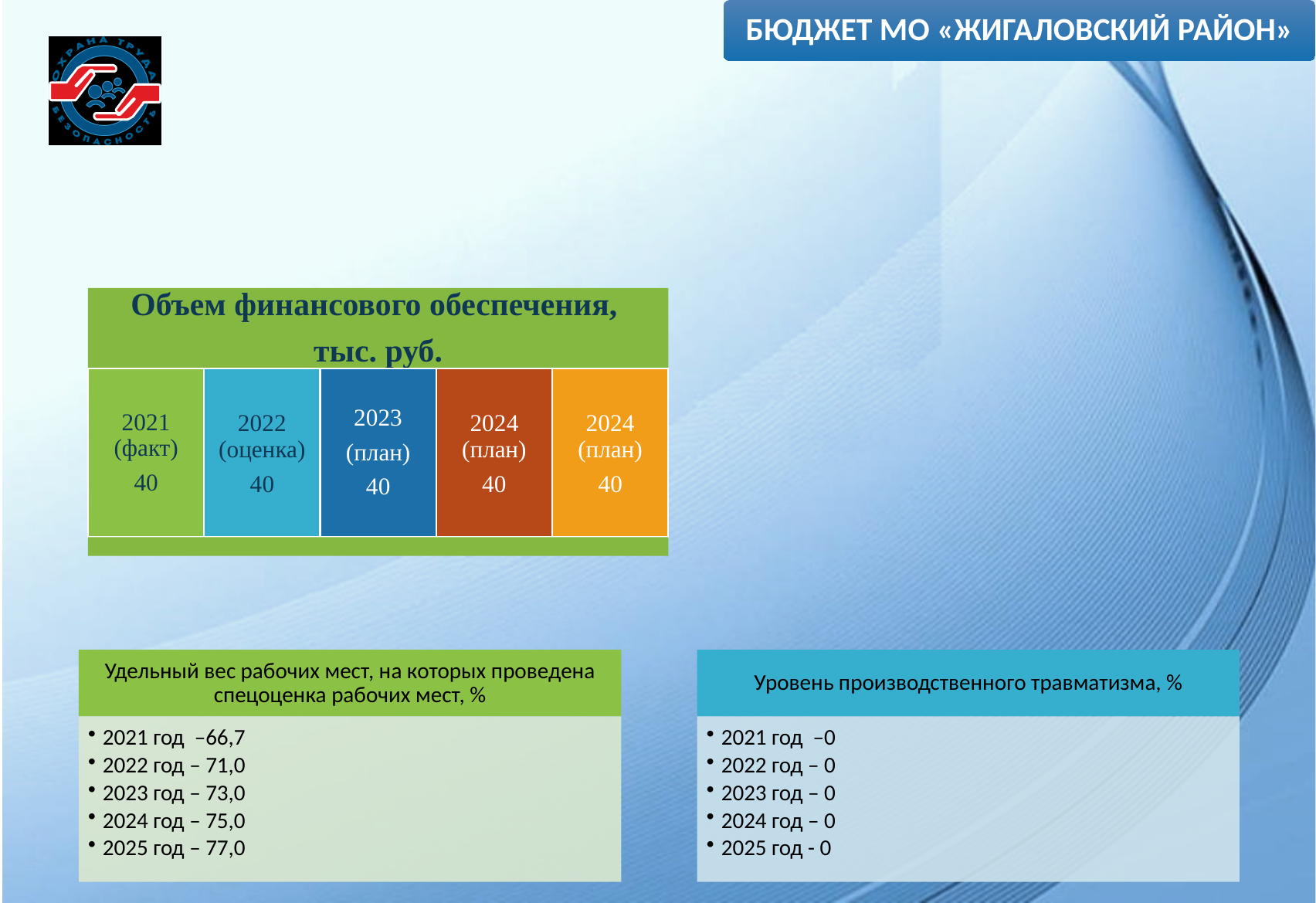
What is the value for 2022 (оценка) in the chart "Объем финансового обеспечения, тыс. руб."? 40 What is the title of the chart on the slide? Объем финансового обеспечения, тыс. руб. What is the value for 2023 (план) in the chart "Объем финансового обеспечения, тыс. руб."? 40 Do the values in the chart "Объем финансового обеспечения, тыс. руб." rise, fall, or stay the same from 2021 to 2024? stay the same In the chart "Объем финансового обеспечения, тыс. руб.", is the value for 2022 (оценка) larger than, smaller than, or equal to the value for 2023 (план)? equal What unit is stated in the title of the chart "Объем финансового обеспечения"? тыс. руб. How many categories (blocks) are shown in the chart "Объем финансового обеспечения, тыс. руб."? 5 Which category label in the chart "Объем финансового обеспечения, тыс. руб." is marked as "факт"? 2021 What is the value for 2021 (факт) in the chart "Объем финансового обеспечения, тыс. руб."? 40 What is the difference between the 2021 (факт) value and the 2024 (план) value in the chart "Объем финансового обеспечения, тыс. руб."? 0